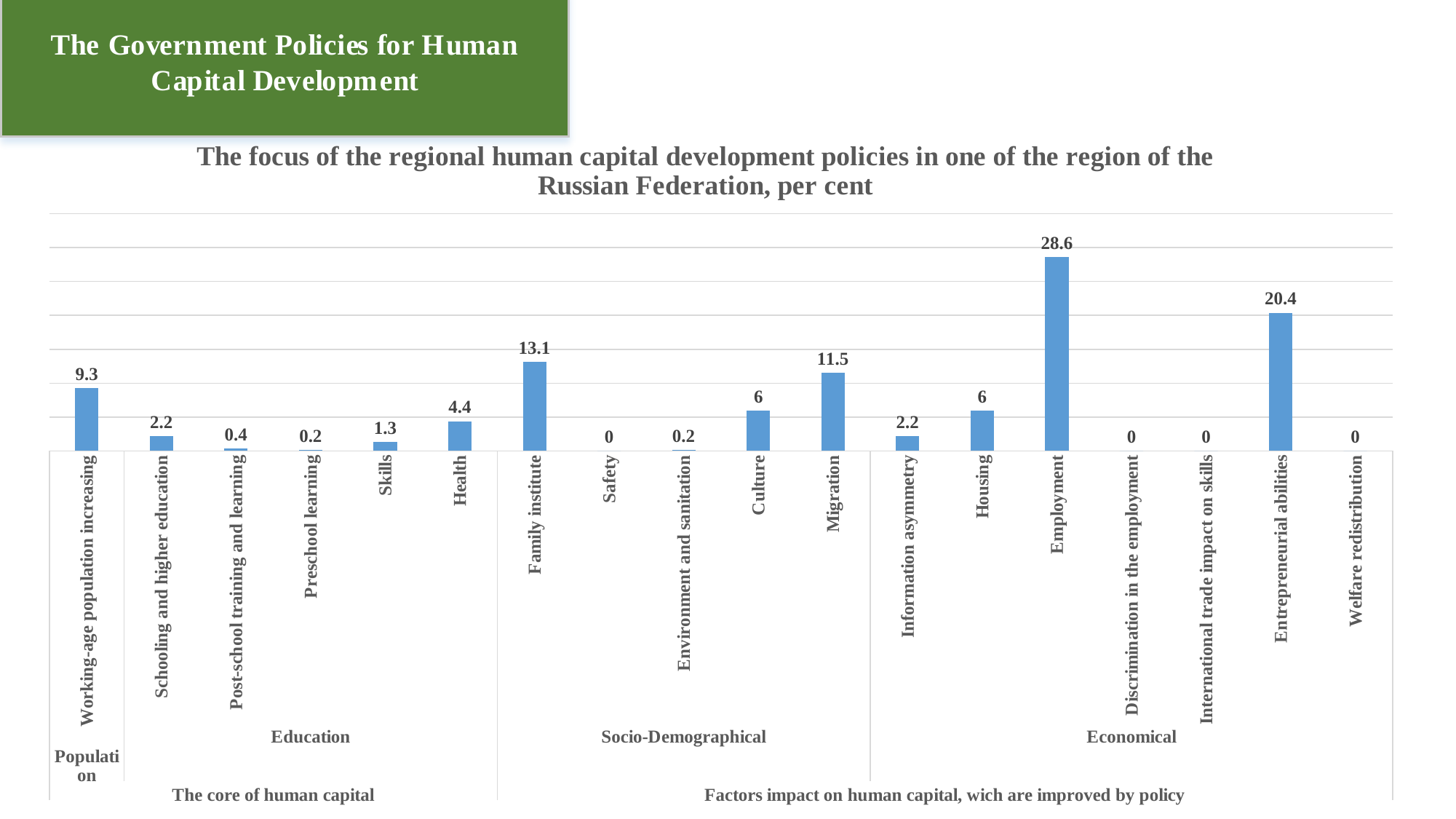
What is the value for Entrepreneurial abilities? 20.4 What is the value for Health? 4.4 What is the difference between the values for Migration and Culture? 5.5 What is the value for Family institute? 13.1 How many categories are shown on the x axis? 18 What is the title of the chart? The focus of the regional human capital development policies in one of the region of the Russian Federation, per cent Which is larger, the value for Migration or the value for Family institute? Family institute What kind of chart is shown on the slide? Bar chart What is the value for Employment? 28.6 Which category has the highest value? Employment What is the value for Working-age population increasing? 9.3 What is the difference between the values for Employment and Entrepreneurial abilities? 8.2